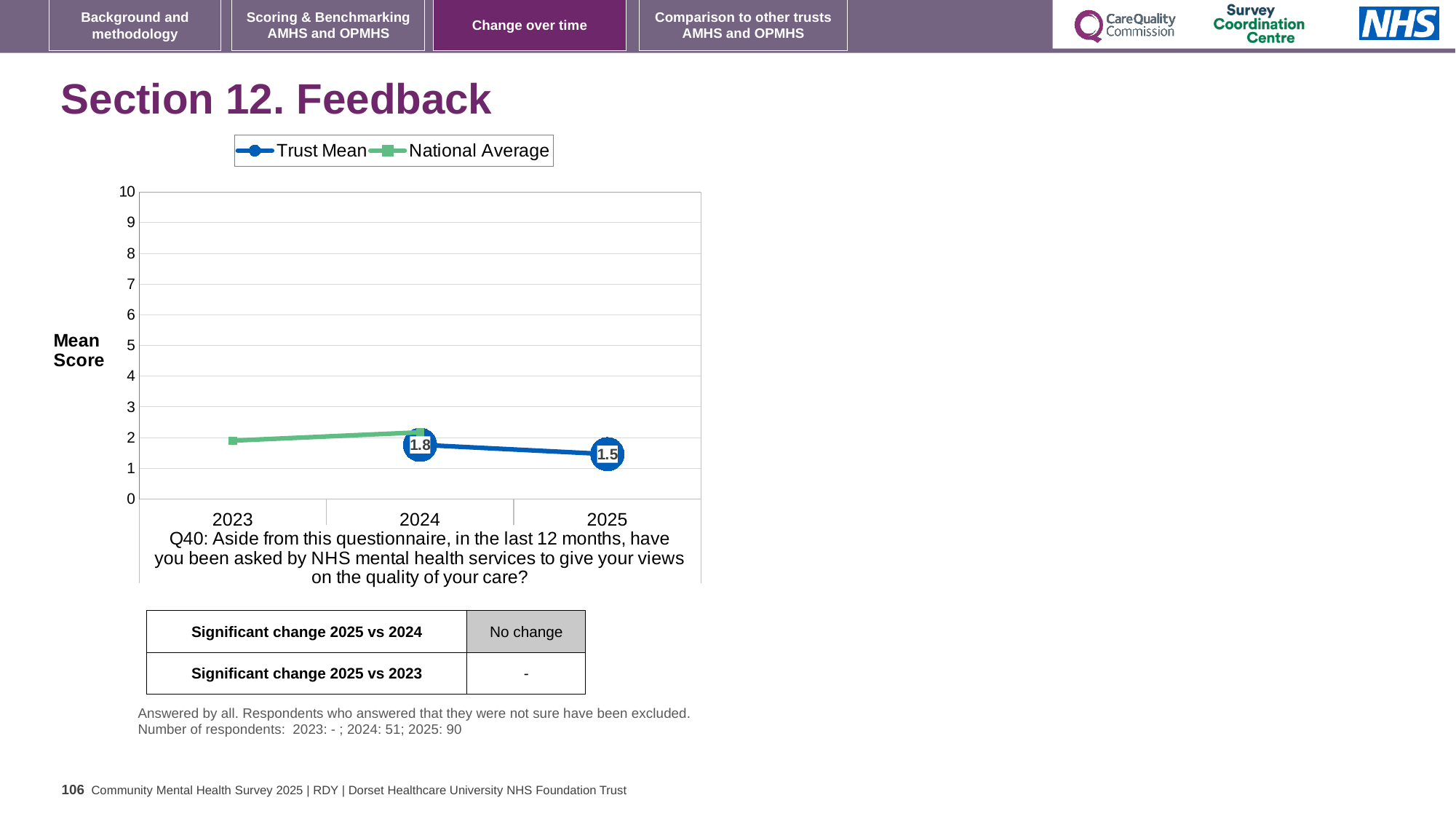
Is the Trust Mean value for 2025 greater or less than 2? less How many years are shown on the x axis? 3 How many series does the legend list? 2 What is the difference between the Trust Mean in 2024 and in 2025? 0.3 Which year has the higher Trust Mean, 2024 or 2025? 2024 What is the Trust Mean value for 2025? 1.5 What are the two series named in the legend? Trust Mean and National Average What is the label on the y axis? Mean Score Does the Trust Mean rise or fall from 2024 to 2025? fall What kind of chart is shown on the slide? line chart Is the National Average value for 2023 greater or less than 3? less What is the Trust Mean value for 2024? 1.8